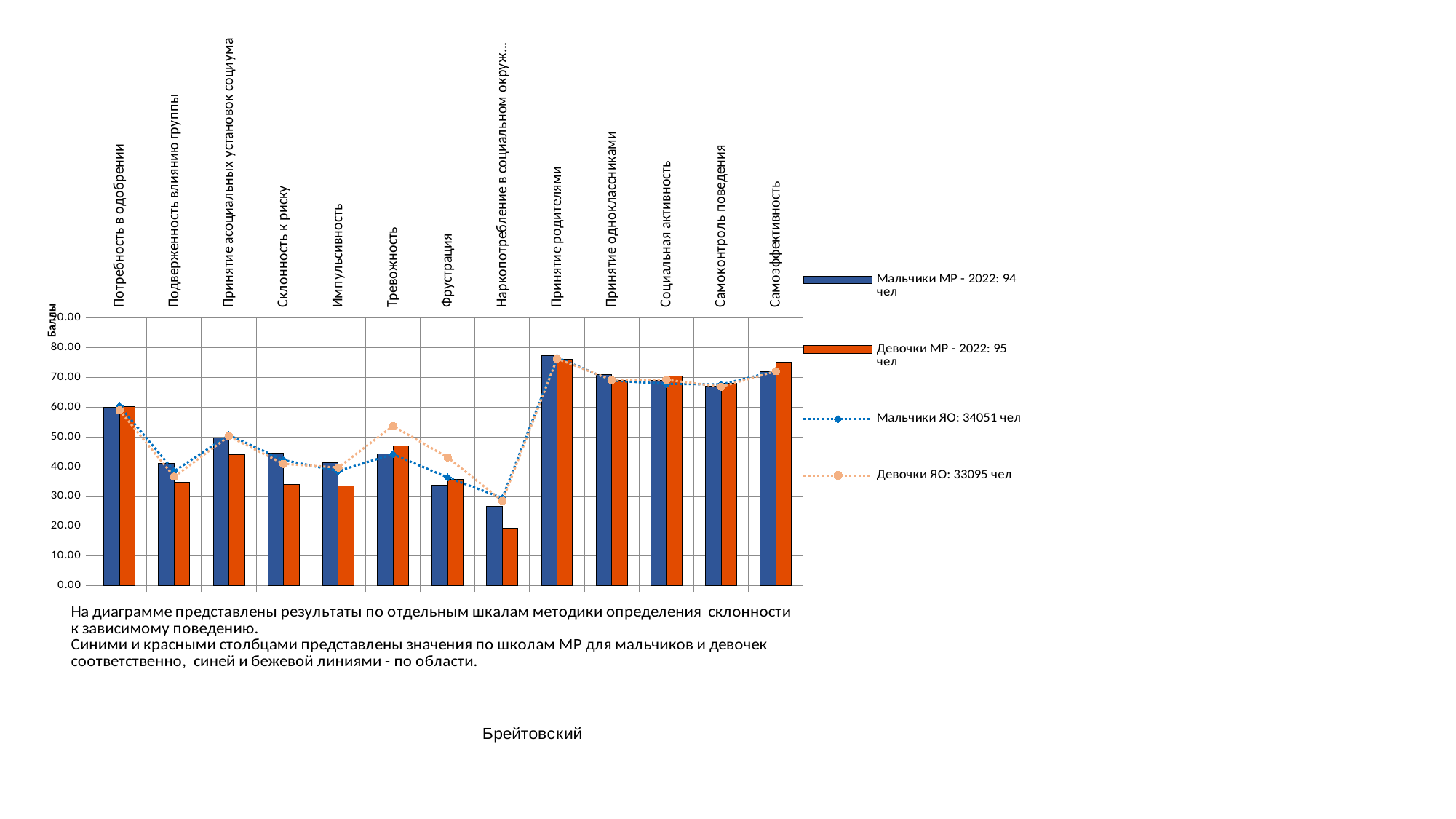
Is the value for Мальчики МР - 2022 in the category Принятие родителями greater or less than 70.00? greater What is the label on the vertical axis of the chart? Баллы For the category Тревожность, which bar is taller: Мальчики МР - 2022 or Девочки МР - 2022? Девочки МР - 2022 How many people does the legend entry for Мальчики ЯО state? 34051 чел Which category has the lowest value for the series Мальчики МР - 2022? Наркопотребление в социальном окруж... How many categories are shown on the x axis of the chart? 13 How many series does the chart legend list? 4 For the category Склонность к риску, which bar is taller: Мальчики МР - 2022 or Девочки МР - 2022? Мальчики МР - 2022 Is the value for Девочки МР - 2022 in the category Наркопотребление в социальном окруж... greater or less than 30.00? less Is the value for Девочки МР - 2022 in the category Склонность к риску greater or less than 40.00? less Which category has the highest value for the series Мальчики МР - 2022? Принятие родителями Which category has the lowest value for the series Девочки МР - 2022? Наркопотребление в социальном окруж...